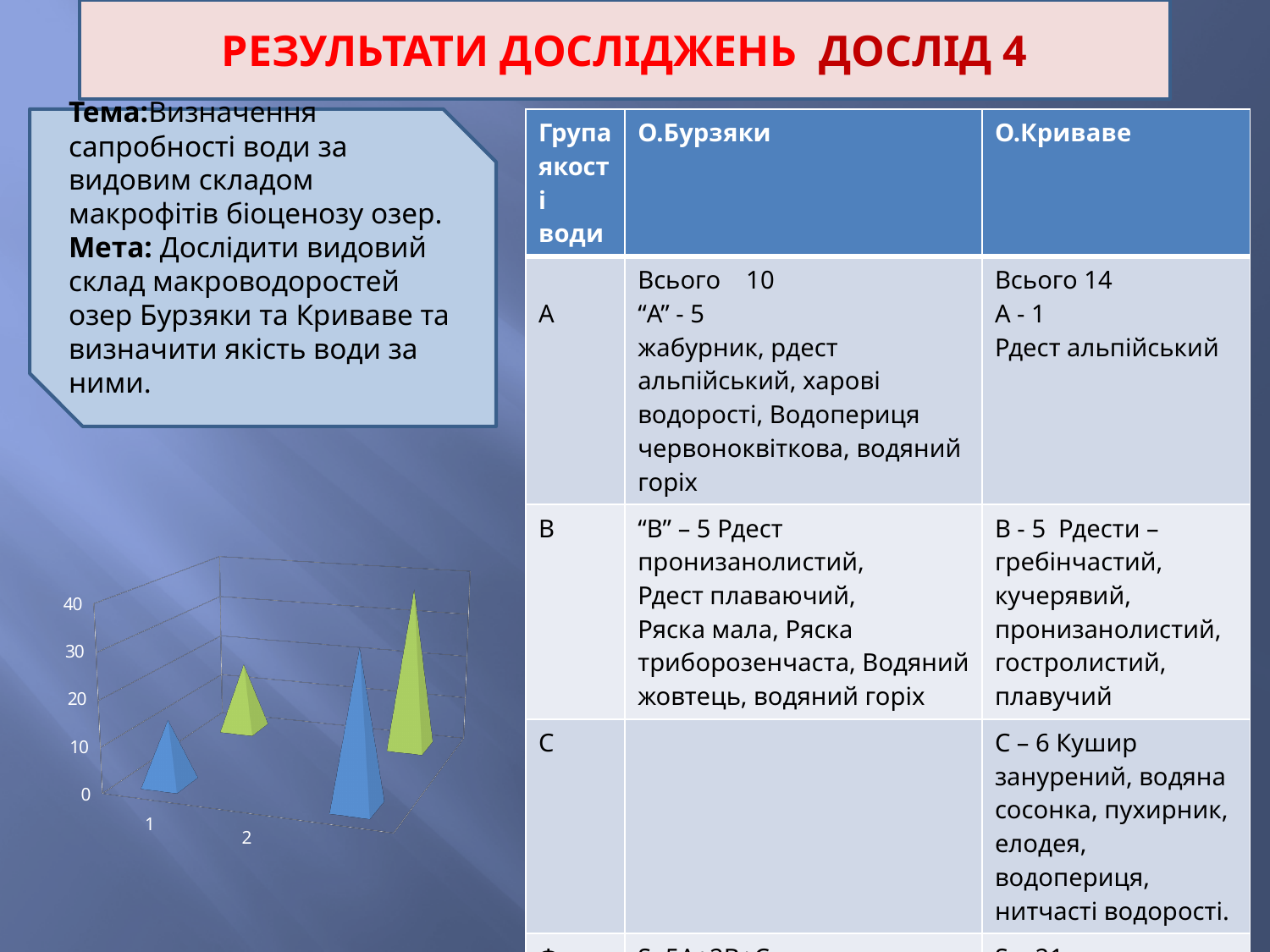
Is the value of the blue series for category 1 greater or less than 20? less What kind of chart is shown on the left of the slide? bar chart How many differently coloured series are plotted in the chart? 2 Which category has the lowest value for the blue series? 1 What is the highest value shown on the vertical axis of the chart? 40